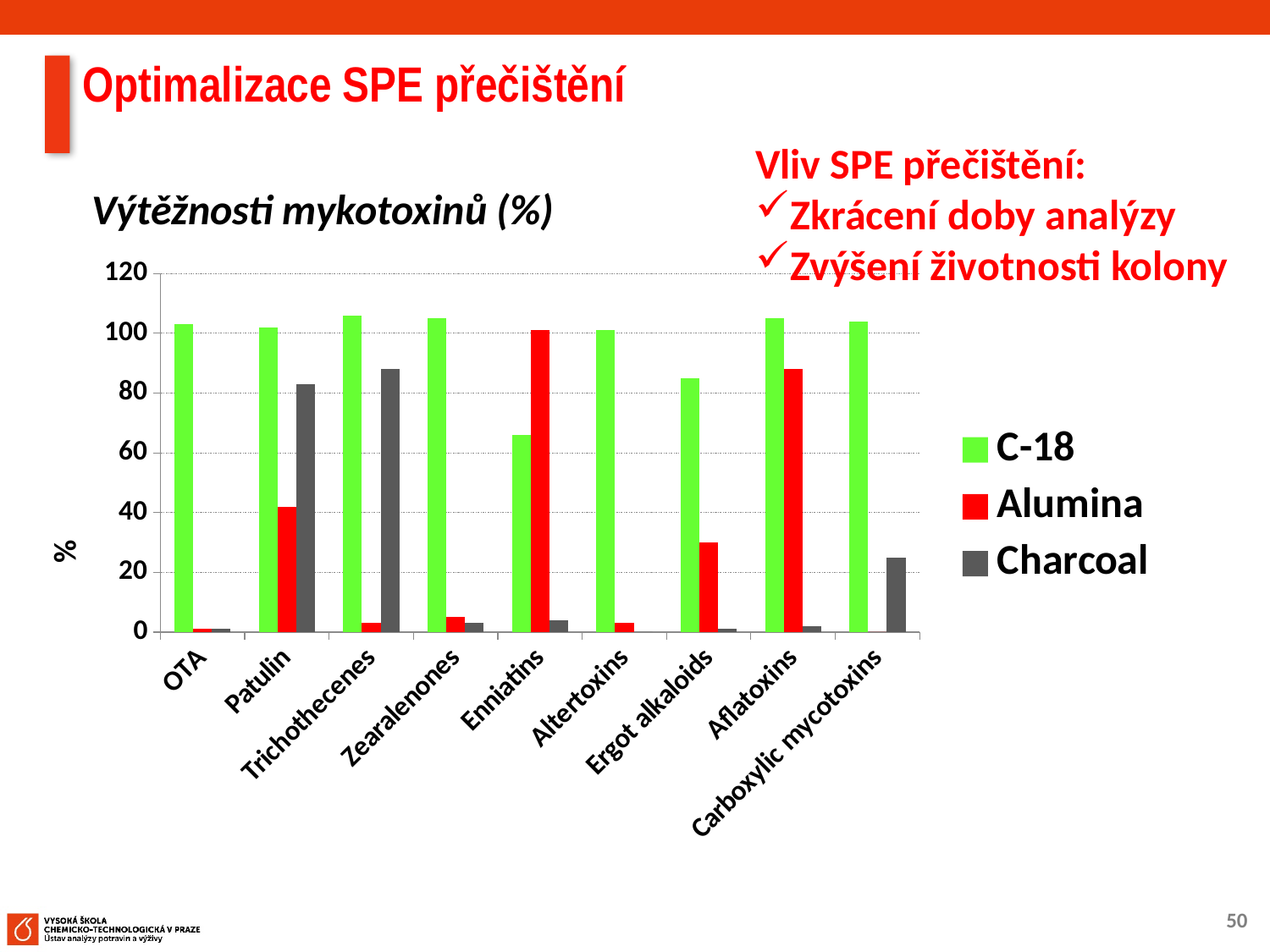
Which series is shown in red in the legend? Alumina Is the Alumina value for Patulin greater or less than 60? less For which category is the Alumina value highest? Enniatins How many series does the legend list? 3 What kind of chart is shown on the slide? bar chart Is the C-18 value for Enniatins greater or less than 60? greater For which category is the C-18 value lowest? Enniatins Is the Charcoal value for Carboxylic mycotoxins greater or less than 20? greater For Enniatins, which is larger: the Alumina value or the Charcoal value? Alumina For Patulin, which is larger: the C-18 value or the Alumina value? C-18 What is the label of the y axis? % How many mycotoxin categories are shown on the x axis? 9